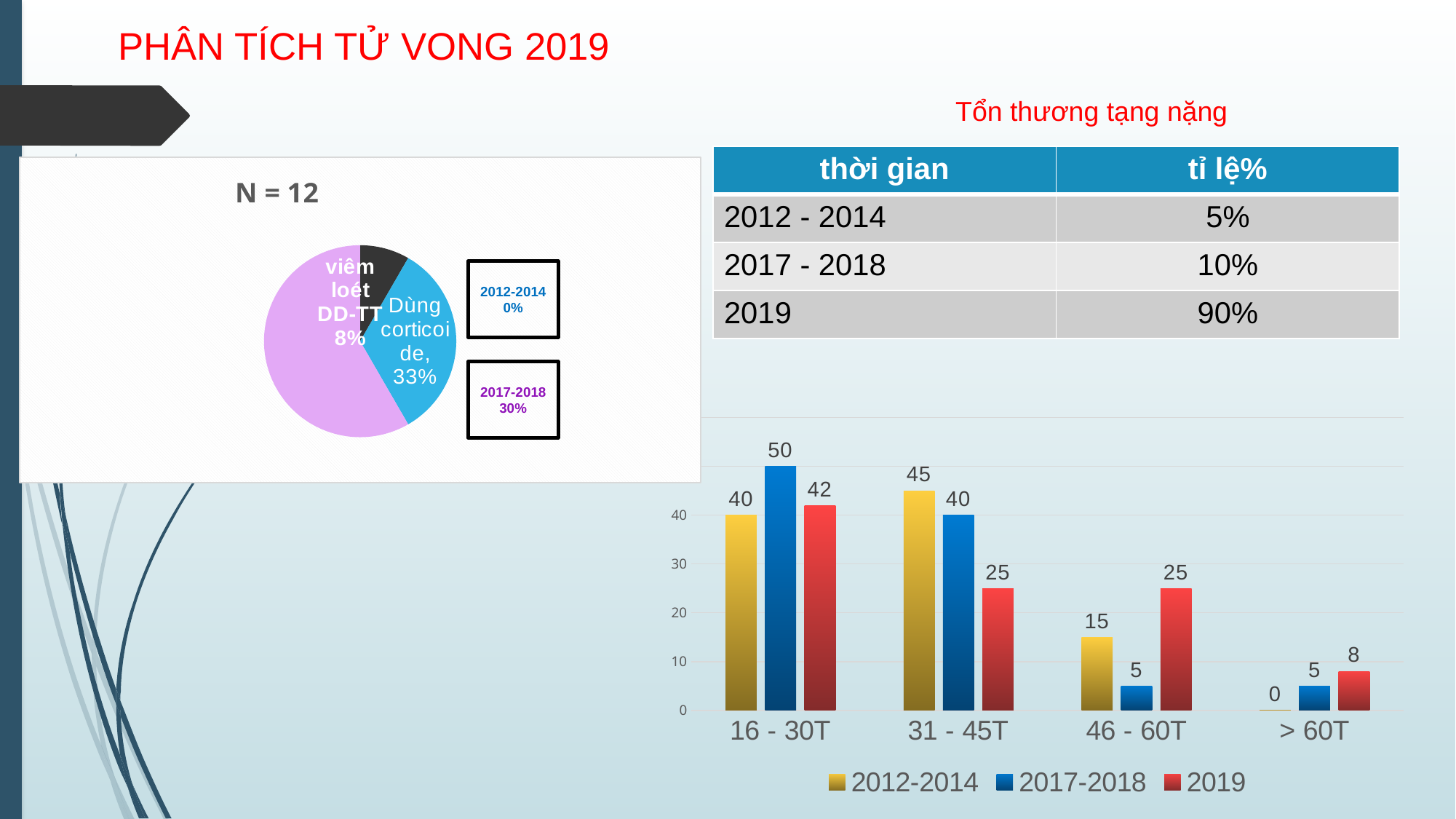
In the bar chart at the bottom right, what is the value for 2017-2018 in the 16 - 30T age group? 50 How many series does the legend of the bar chart at the bottom right list? 3 In the bar chart at the bottom right, what is the value for 2012-2014 in the 46 - 60T age group? 15 In the pie chart on the left, what share is labelled for 'Dùng corticoide'? 33% In the bar chart at the bottom right, which age group has the highest value for the 2019 series? 16 - 30T In the bar chart at the bottom right, what is the difference between the 2012-2014 and 2019 values in the 31 - 45T age group? 20 In the bar chart at the bottom right, which age group has the lowest value for the 2017-2018 series? 46 - 60T and > 60T (both 5) How many age groups are shown on the x axis of the bar chart at the bottom right? 4 In the bar chart at the bottom right, which is larger in the 46 - 60T age group: the 2017-2018 value or the 2019 value? 2019 In the bar chart at the bottom right, what is the value for 2012-2014 in the > 60T age group? 0 In the bar chart at the bottom right, what is the value for 2019 in the 31 - 45T age group? 25 What kind of chart is the chart at the bottom right of the slide? bar chart